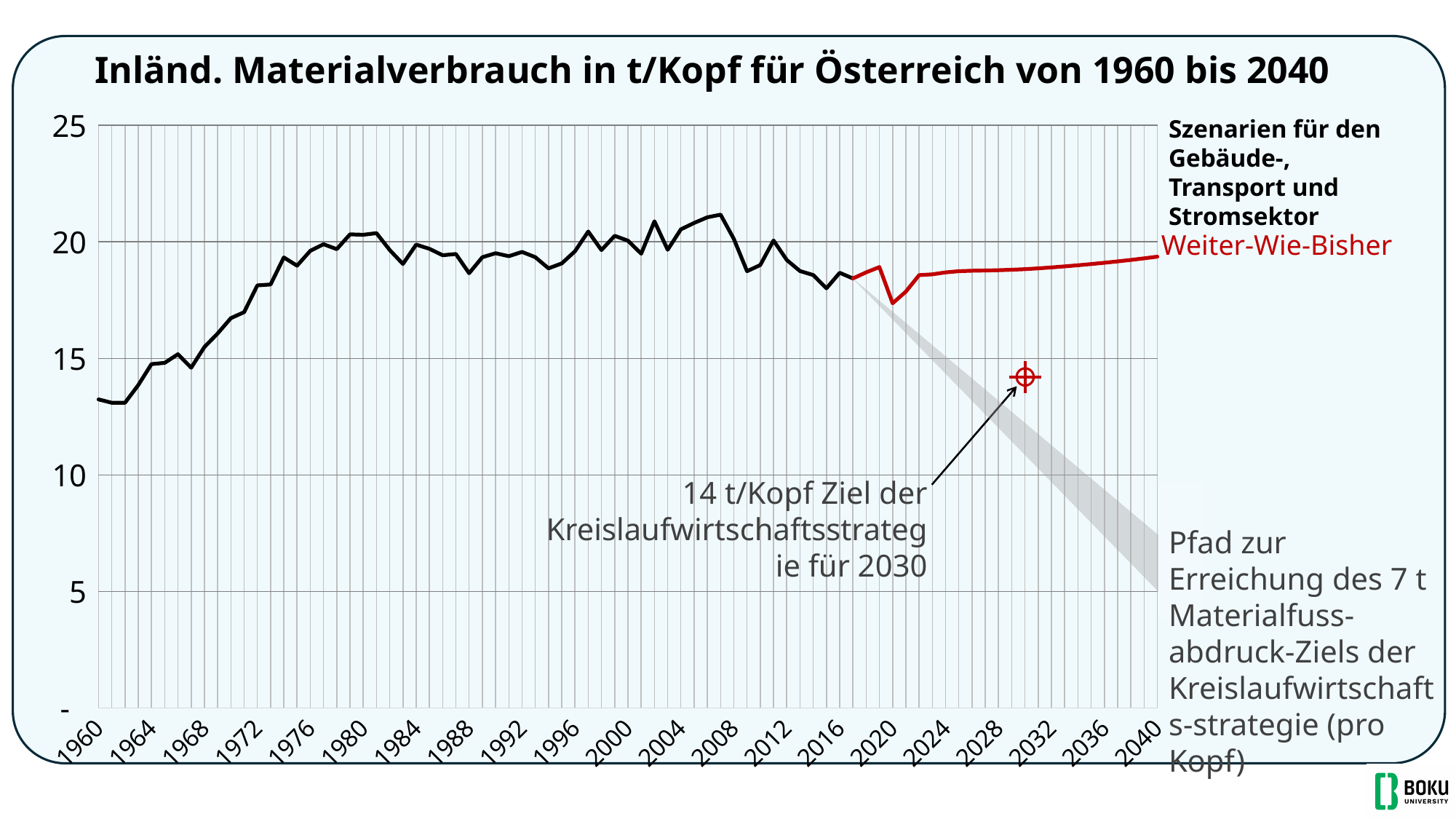
What is the name of the red scenario line in the chart? Weiter-Wie-Bisher What material footprint target (per Kopf) does the grey path in the chart lead towards? 7 t What target value in t/Kopf does the Kreislaufwirtschaftsstrategie set for 2030, according to the chart annotation? 14 t/Kopf What is the title of the chart? Inländ. Materialverbrauch in t/Kopf für Österreich von 1960 bis 2040 Is the value for 2016 greater or less than 20? less Does the value rise or fall between 1960 and 1980? rise Which year has the larger value, 1960 or 1980? 1980 Is the value for 1972 greater or less than 15? greater Does the value rise or fall between 2008 and 2016? fall What kind of chart is shown on the slide? line chart Is the value for 1960 greater or less than 15? less